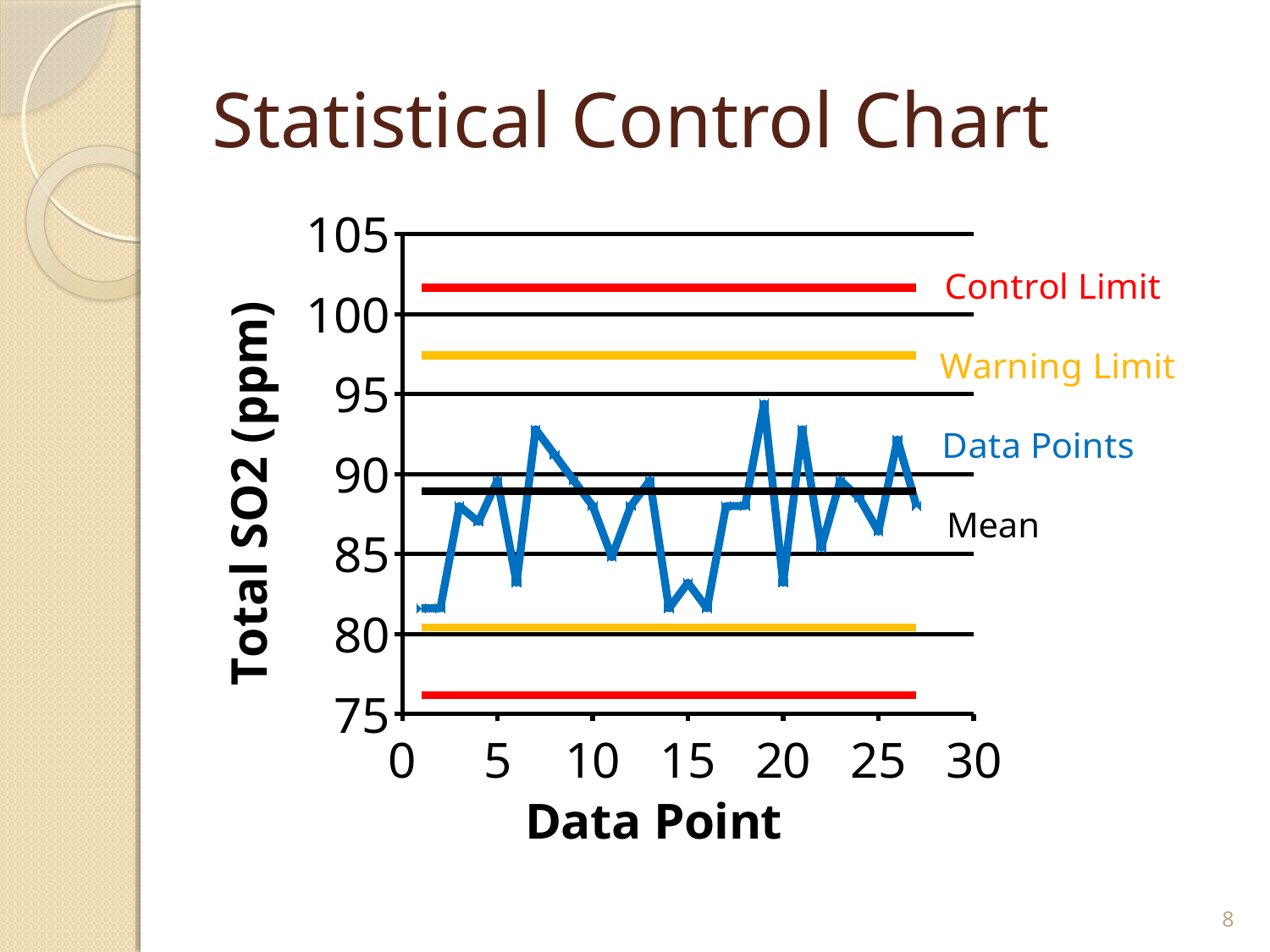
Which is larger, the value at data point 19 or the value at data point 16? data point 19 Is the value for data point 14 greater or less than 85? less Is the upper Control Limit line greater or less than 100? greater Is the value for data point 1 greater or less than 85? less What is the title of the chart on the slide? Statistical Control Chart What is the label of the y axis? Total SO2 (ppm) What kind of chart is shown on the slide? line chart